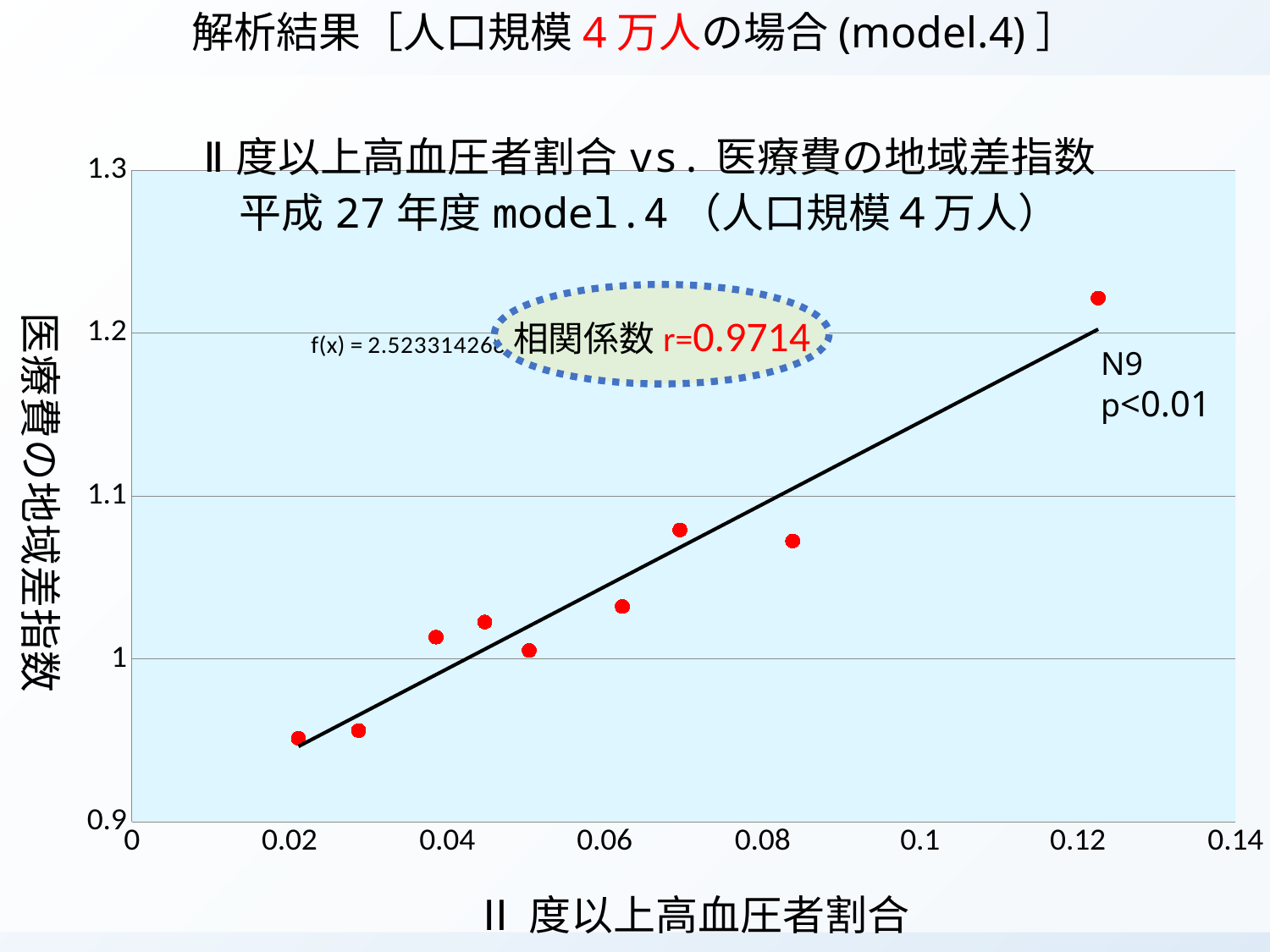
Is the y value of the rightmost data point greater or less than 1.2? greater What correlation coefficient (r) is shown on the chart? r=0.9714 Do the plotted values generally rise or fall as the x-axis value (Ⅱ度以上高血圧者割合) increases? rise What p-value is shown on the chart? p<0.01 Is the y value of the data point near x = 0.084 greater or less than 1.1? less Is the y value of the leftmost data point greater or less than 1? less How many data points have a y value above 1.1? 1 How many data points are plotted in the chart? 9 What kind of chart is shown on the slide? scatter chart How many data points have a y value below 1? 2 Which has the larger y value: the rightmost data point or the leftmost data point? the rightmost data point